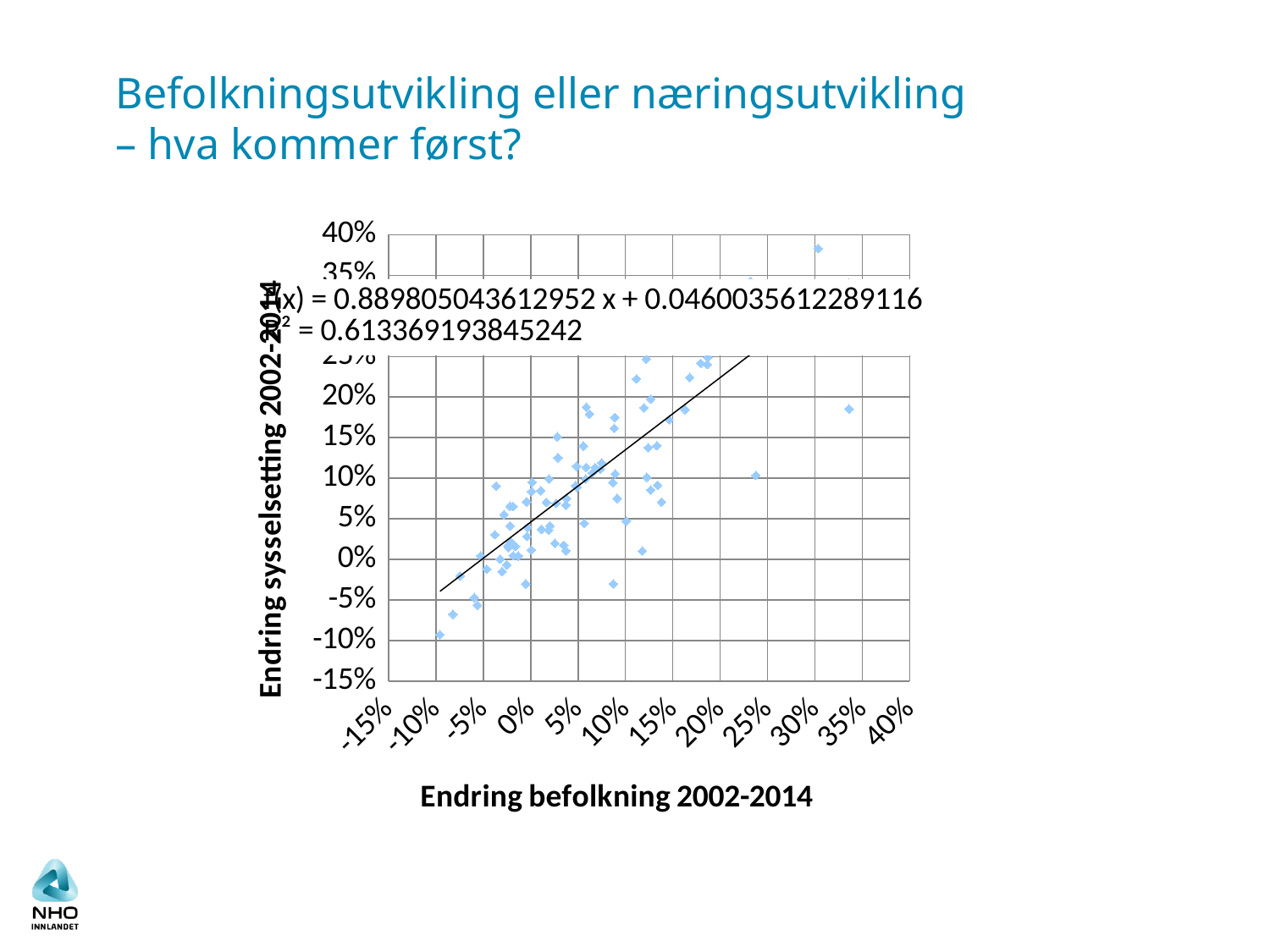
According to the trendline equation shown on the chart, what is the slope of the fitted line? 0.889805043612952 Is the vertical-axis value of the lowest point on the chart greater or less than -5%? less What R² value is printed on the chart? 0.613369193845242 What is the maximum value shown on the vertical axis of the chart? 40% Is the vertical-axis value of the highest point on the chart greater or less than 30%? greater Does the trendline on the chart rise or fall as the horizontal axis value increases? Rises What is the title of the horizontal axis of the chart? Endring befolkning 2002-2014 According to the trendline equation shown on the chart, what is the intercept of the fitted line? 0.0460035612289116 What is the title of the vertical axis of the chart? Endring sysselsetting 2002-2014 What kind of chart is shown on the slide? Scatter chart